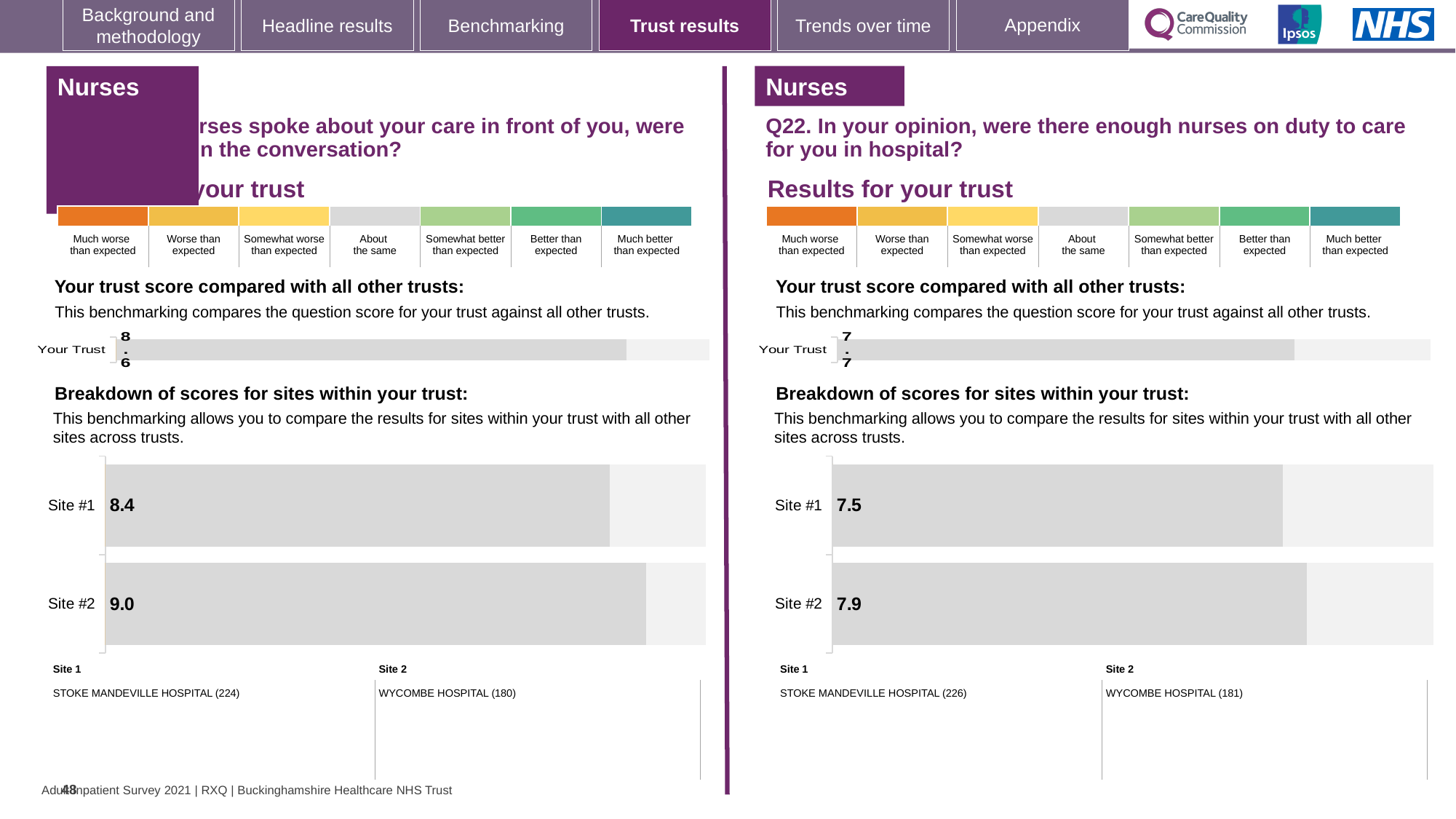
On the left-hand site breakdown chart, what is the score for Site #2? 9.0 What type of chart is used for the site breakdown on the left-hand side of the slide? Bar chart On the left-hand site breakdown chart, which site has the higher score? Site #2 How many sites are shown on the Q22 site breakdown chart on the right? 2 On the Q22 site breakdown chart on the right, what is the score for Site #2? 7.9 On the left-hand site breakdown chart, what is the difference between the Site #2 and Site #1 scores? 0.6 On the Q22 'Your trust score compared with all other trusts' chart on the right, what is the score for Your Trust? 7.7 On the Q22 site breakdown chart on the right, what is the difference between the Site #2 and Site #1 scores? 0.4 On the left-hand site breakdown chart, what is the score for Site #1? 8.4 On the Q22 site breakdown chart on the right, what is the score for Site #1? 7.5 On the left-hand 'Your trust score compared with all other trusts' chart, what is the score for Your Trust? 8.6 On the Q22 site breakdown chart on the right, which site has the lower score? Site #1